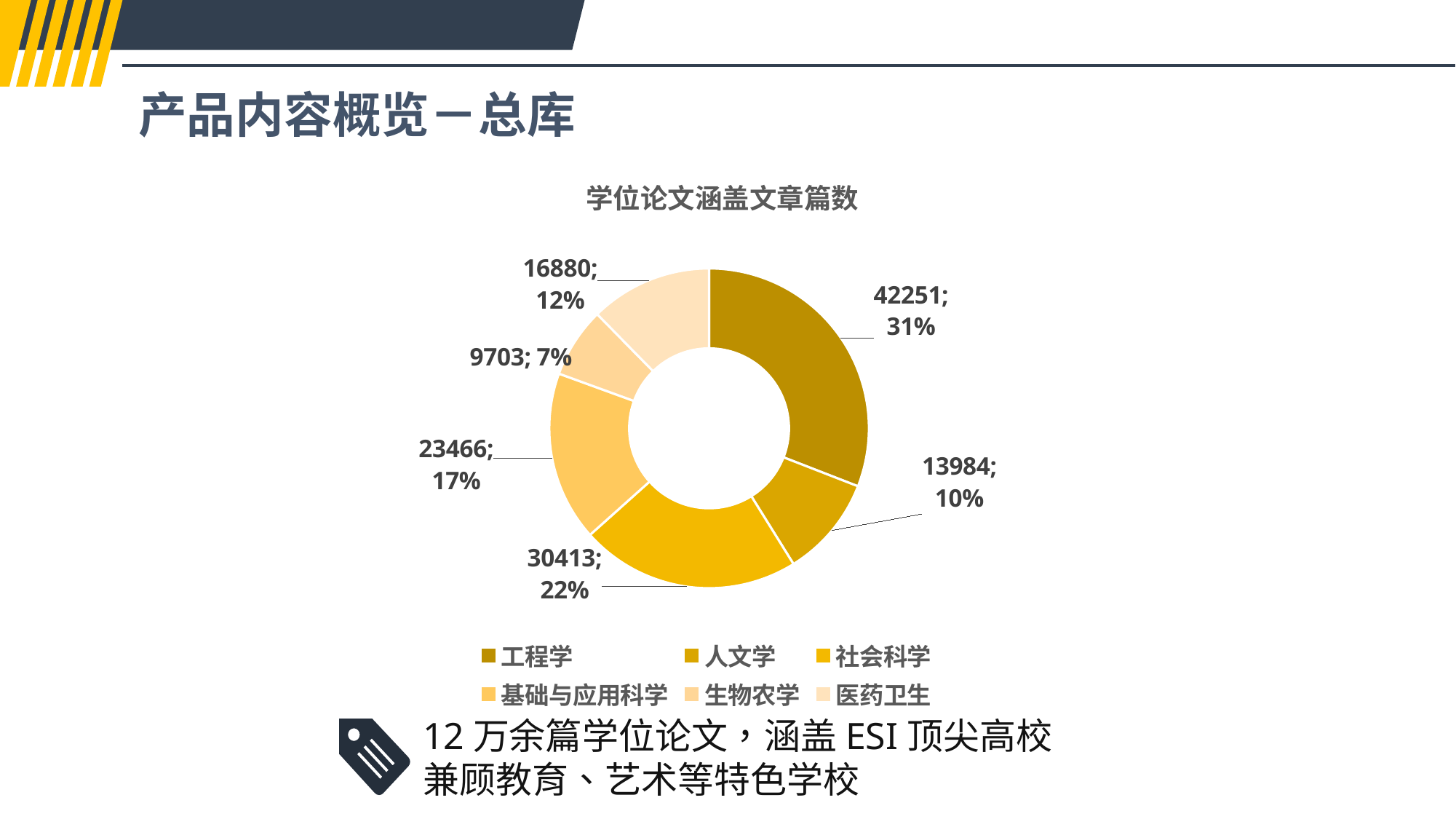
Which category has the lowest value? 生物农学 What kind of chart is shown on the slide? Doughnut (pie) chart What is the title of the chart? 学位论文涵盖文章篇数 What is the value for 工程学? 42251 Which is larger, the value for 社会科学 or the value for 基础与应用科学? 社会科学 What share of the chart does 基础与应用科学 represent? 17% What is the value for 社会科学? 30413 Which category has the highest value? 工程学 How many categories does the chart show? 6 What is the value for 生物农学? 9703 What share of the chart does 医药卫生 represent? 12% What is the difference between the values for 工程学 and 人文学? 28267